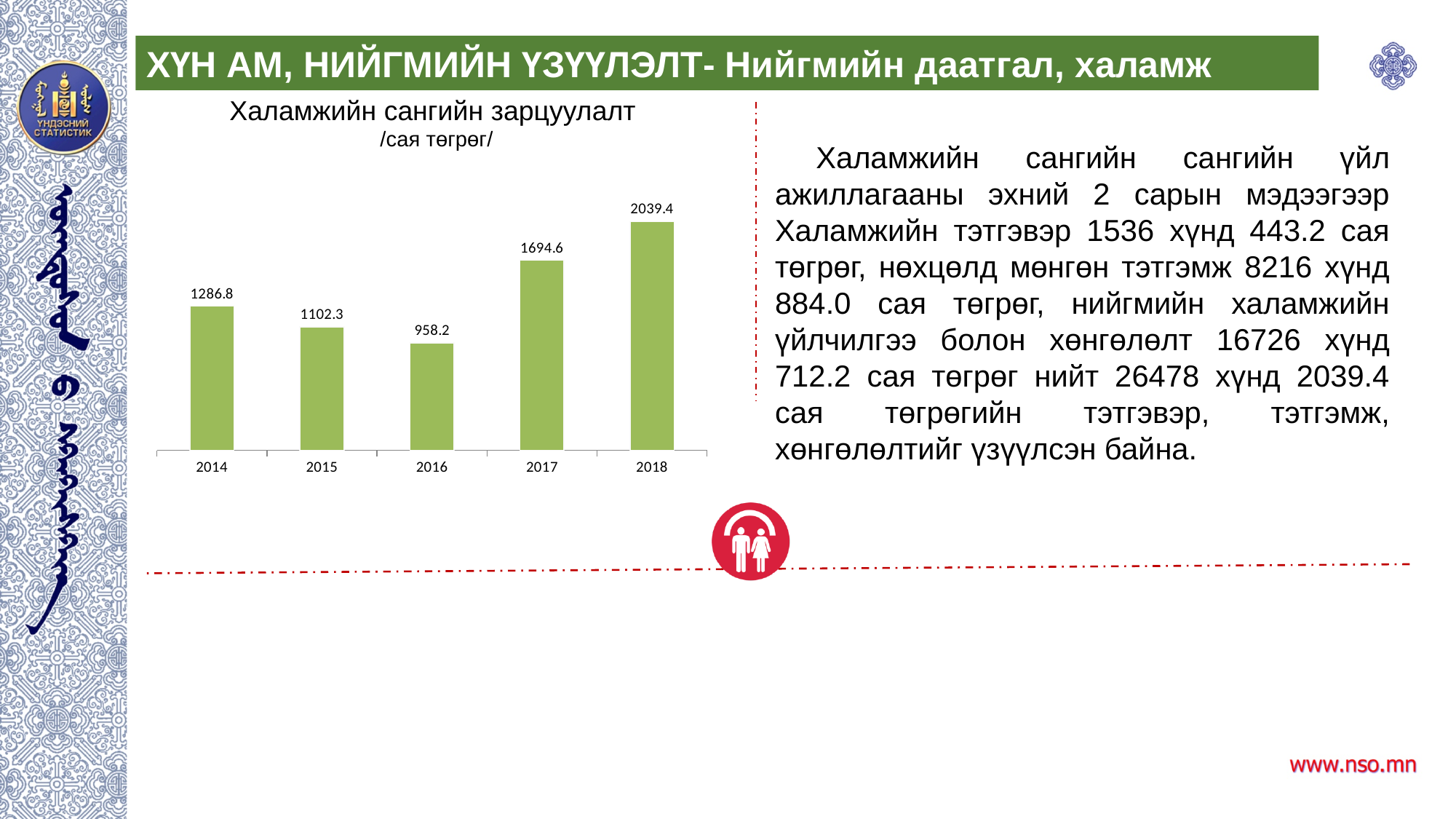
What is the title of the chart? Халамжийн сангийн зарцуулалт What is the difference between the values for 2014 and 2015? 184.5 What is the value for 2016? 958.2 Which is larger, the value for 2015 or the value for 2017? 2017 Which year has the lowest value? 2016 What kind of chart is shown? bar chart Which year has the highest value? 2018 What is the value for 2014? 1286.8 What is the difference between the values for 2018 and 2017? 344.8 Do the values rise or fall from 2016 to 2018? rise How many years are shown on the x axis? 5 What is the value for 2018? 2039.4